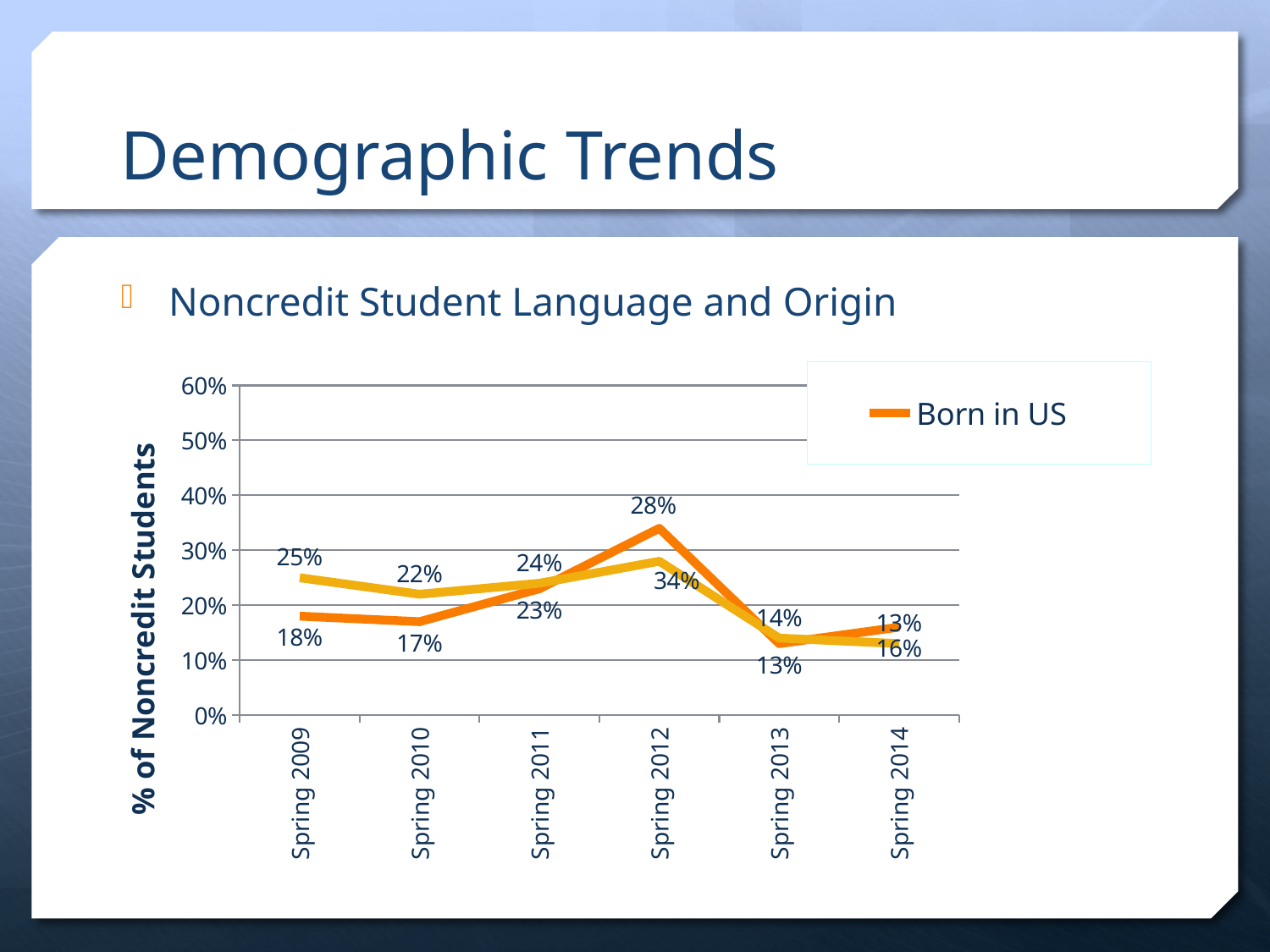
What is the Born in US value for Spring 2012? 34% How many series does the legend list? 1 Which is larger for Born in US: Spring 2011 or Spring 2014? Spring 2011 In which term is the Born in US value lowest? Spring 2013 How many terms are shown on the x axis? 6 Is the Born in US value for Spring 2012 greater or less than 30%? greater Does the Born in US value rise or fall from Spring 2012 to Spring 2013? fall What is the Born in US value for Spring 2014? 16% What is the difference between the Born in US values for Spring 2012 and Spring 2013? 21 percentage points What is the Born in US value for Spring 2009? 18% What kind of chart is shown on the slide? line chart In which term is the Born in US value highest? Spring 2012